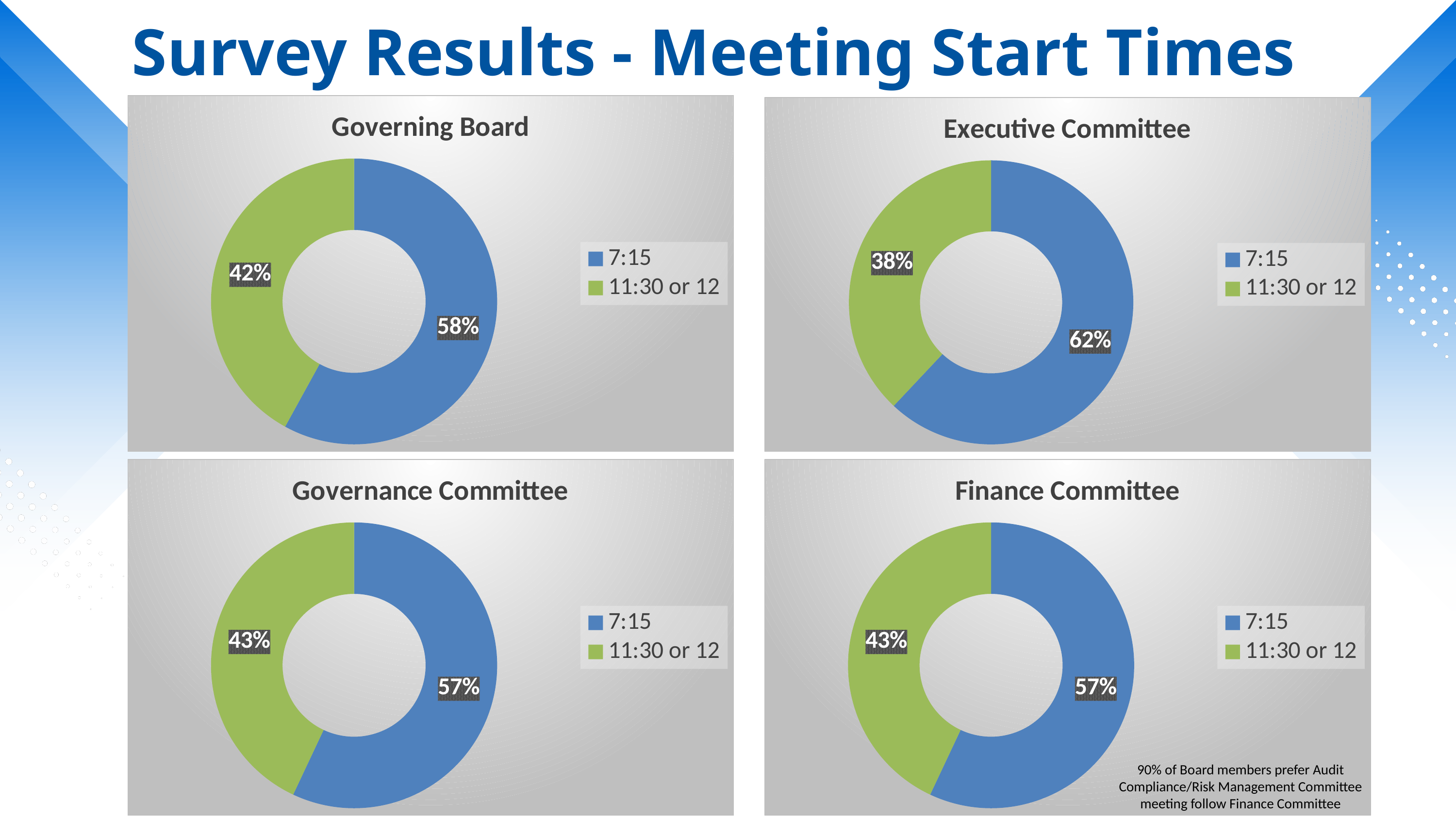
In the Governing Board chart, which start time has the smaller share? 11:30 or 12 In the Executive Committee chart, what share of respondents prefer 7:15? 62% In the Finance Committee chart, what share of respondents prefer 7:15? 57% How many entries does the legend of the Governing Board chart list? 2 In the Executive Committee chart, what is the difference between the 7:15 share and the 11:30 or 12 share? 24% What kind of chart is the Finance Committee chart? Doughnut chart In the Governance Committee chart, what share of respondents prefer 11:30 or 12? 43% In the Governing Board chart, what share of respondents prefer 11:30 or 12? 42% In the Governing Board chart, what share of respondents prefer 7:15? 58% In the Executive Committee chart, what share of respondents prefer 11:30 or 12? 38% In the Governance Committee chart, is the share for 7:15 larger or smaller than the share for 11:30 or 12? larger In the Executive Committee chart, which start time has the larger share? 7:15